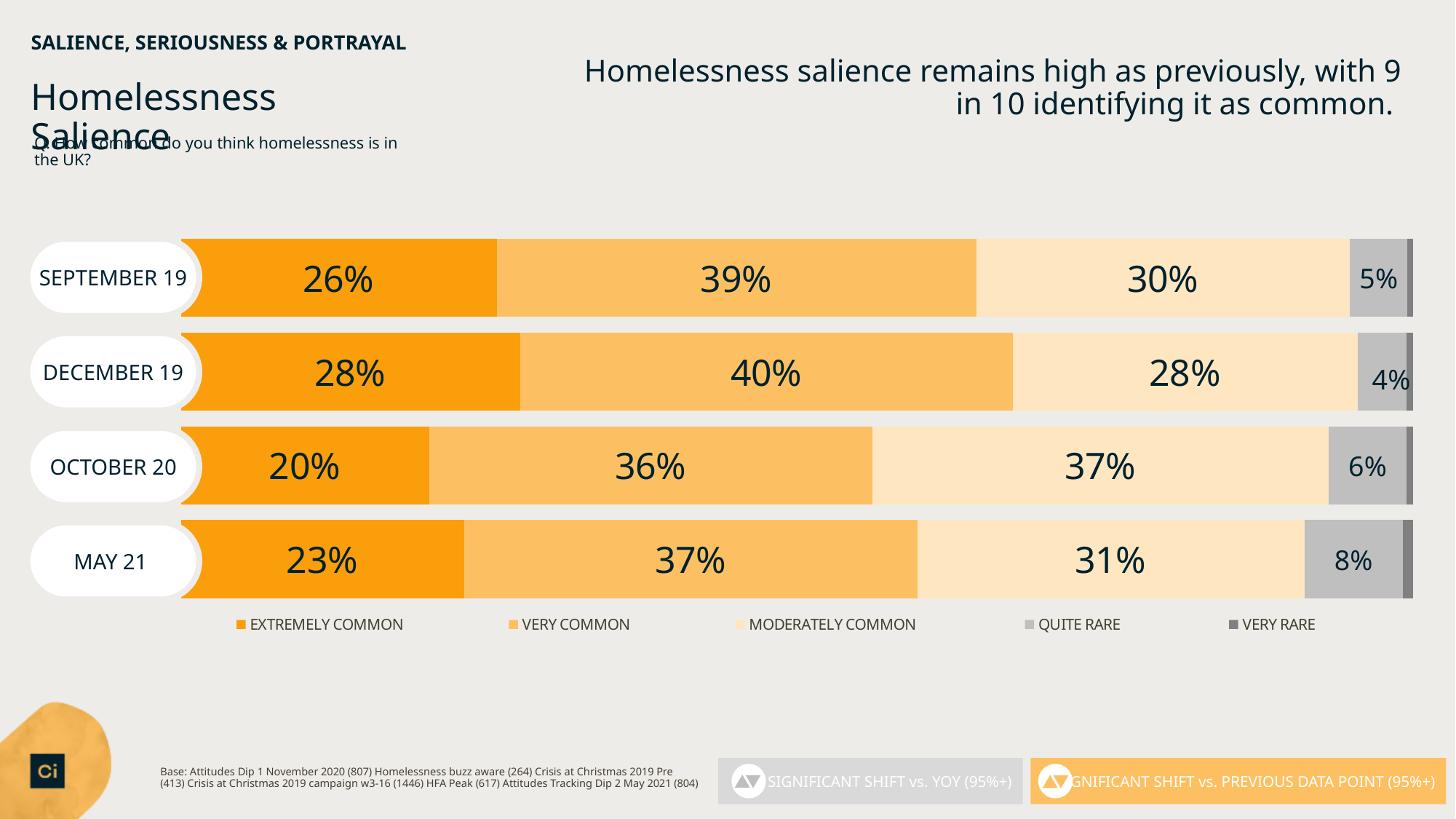
What is the Quite Rare value for September 19? 5% Which time period has the highest Extremely Common value? December 19 What kind of chart is shown on the slide? Stacked bar chart Which time period has the lowest Extremely Common value? October 20 What is the Moderately Common value for May 21? 31% How many time periods (categories) are shown in the chart? 4 What is the difference between the Moderately Common values for October 20 and December 19? 9% Which is larger: the Quite Rare value for May 21 or for October 20? May 21 How many series does the legend list? 5 Which series is shown in the darkest orange colour in the legend? Extremely Common What is the Extremely Common value for December 19? 28% What is the Very Common value for October 20? 36%